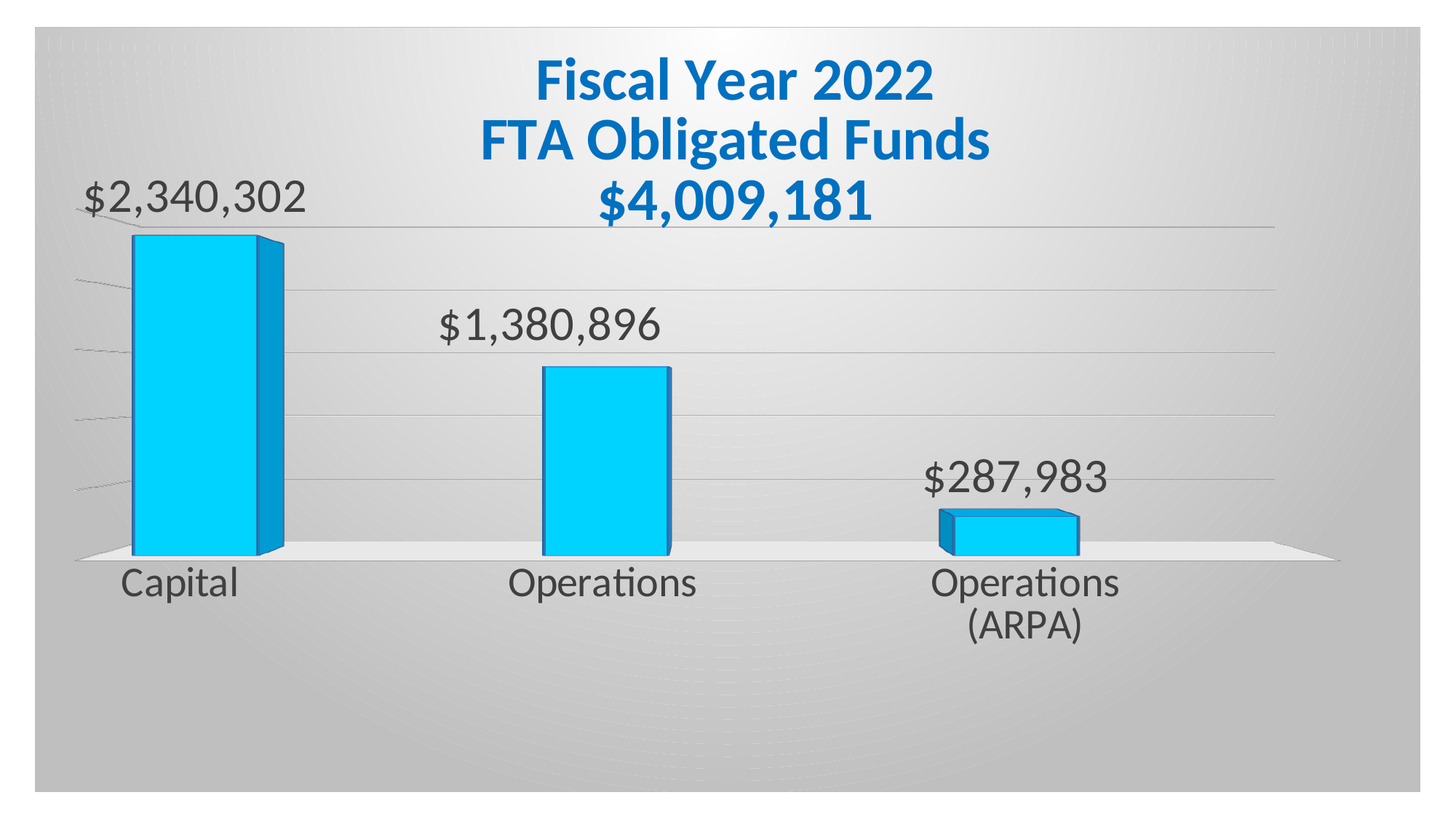
Which category has the highest value? Capital How many categories are shown in the chart? 3 What is the difference between the Capital and Operations values? $959,406 What kind of chart is this? Bar chart What is the difference between the Operations and Operations (ARPA) values? $1,092,913 Which is larger, the value for Operations or the value for Operations (ARPA)? Operations What is the value for Operations? $1,380,896 Do the values rise or fall from left to right across the categories? Fall What is the value for Operations (ARPA)? $287,983 What total amount is shown in the chart title? $4,009,181 What is the value for Capital? $2,340,302 Which category has the lowest value? Operations (ARPA)